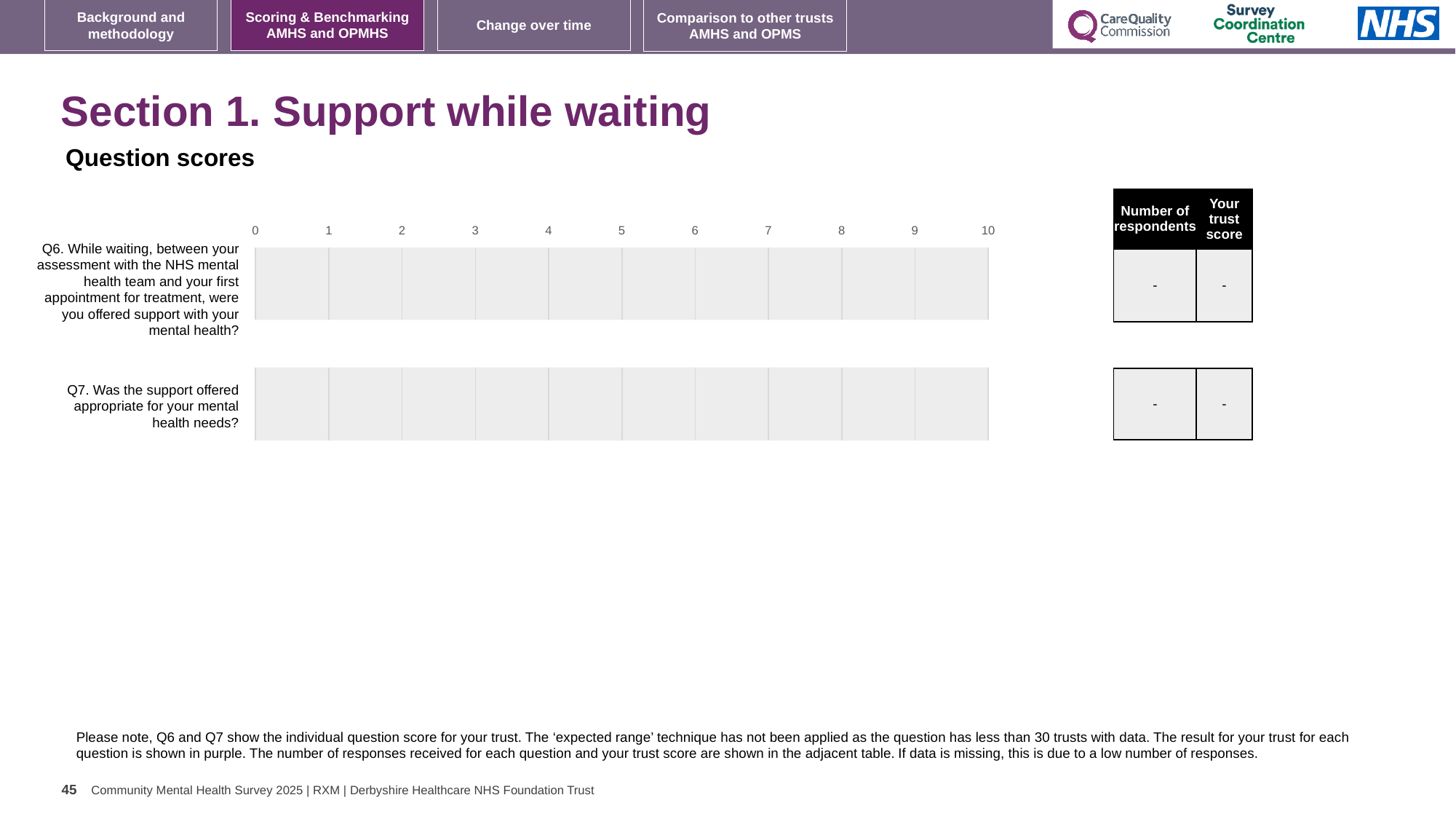
What is the lowest value shown on the chart's horizontal axis? 0 How many questions (categories) are listed on the chart? 2 What is the 'Your trust score' value shown in the table for Q6? - What is the highest value shown on the chart's horizontal axis? 10 What is the 'Number of respondents' value shown in the table for Q7? - What kind of chart is used on this slide? bar chart What is the 'Number of respondents' value shown in the table for Q6? - What is the 'Your trust score' value shown in the table for Q7? -